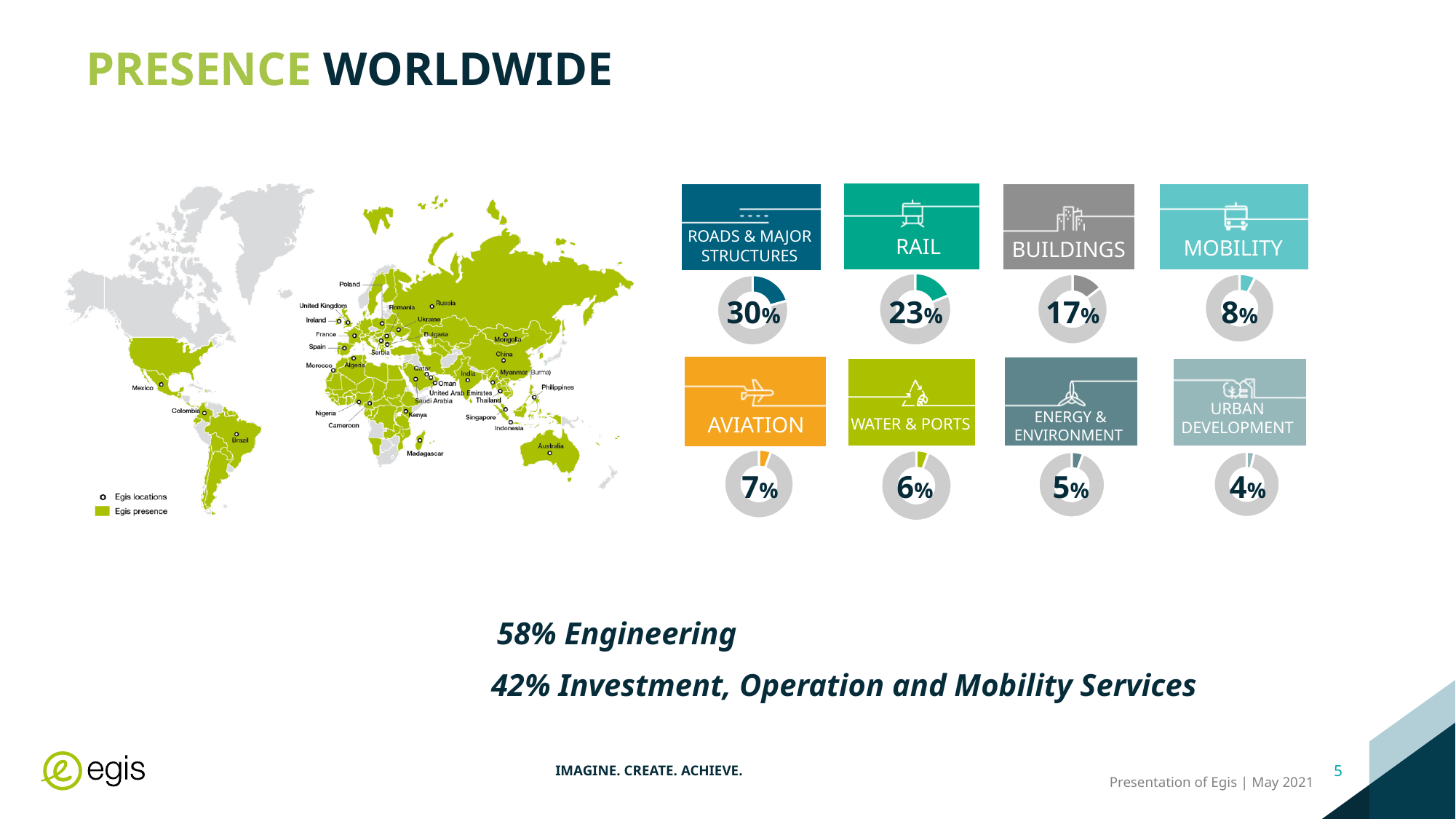
What percentage is shown for Energy & Environment? 5% How many sector donut charts are shown on the slide? 8 Which has a larger percentage, Water & Ports or Energy & Environment? Water & Ports What is the difference in percentage points between Roads & Major Structures and Rail? 7 What percentage is shown for Rail? 23% Which sector has the lowest percentage among the donut charts? Urban Development What percentage is shown for Roads & Major Structures? 30% What kind of chart is used to show each sector's percentage? Donut chart What percentage is shown for Buildings? 17% Which has a larger percentage, Buildings or Mobility? Buildings What is the difference in percentage points between Mobility and Aviation? 1 Which sector has the highest percentage among the donut charts? Roads & Major Structures